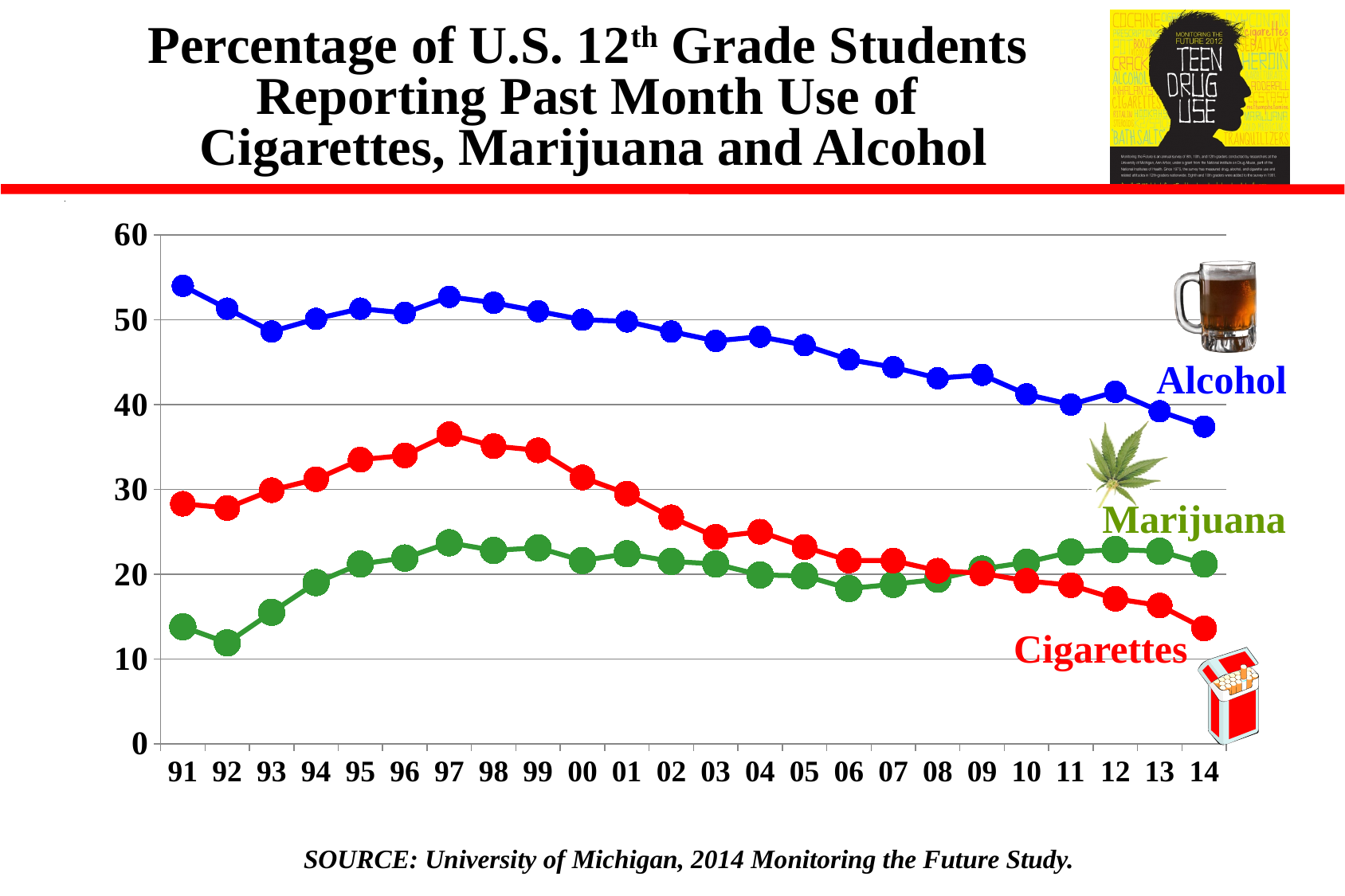
How many series are plotted on the chart? 3 How many years are shown along the x axis? 24 In 14, which is higher: Marijuana or Cigarettes? Marijuana Is the value for Cigarettes in 97 greater or less than 30? greater In which year does the Cigarettes series reach its highest value? 97 Does the Alcohol series rise or fall overall from 91 to 14? fall What kind of chart is shown on the slide? line chart In which year does the Marijuana series reach its lowest value? 92 Is the value for Alcohol in 91 greater or less than 50? greater Is the value for Marijuana in 92 greater or less than 20? less Which series has the highest value in 97? Alcohol